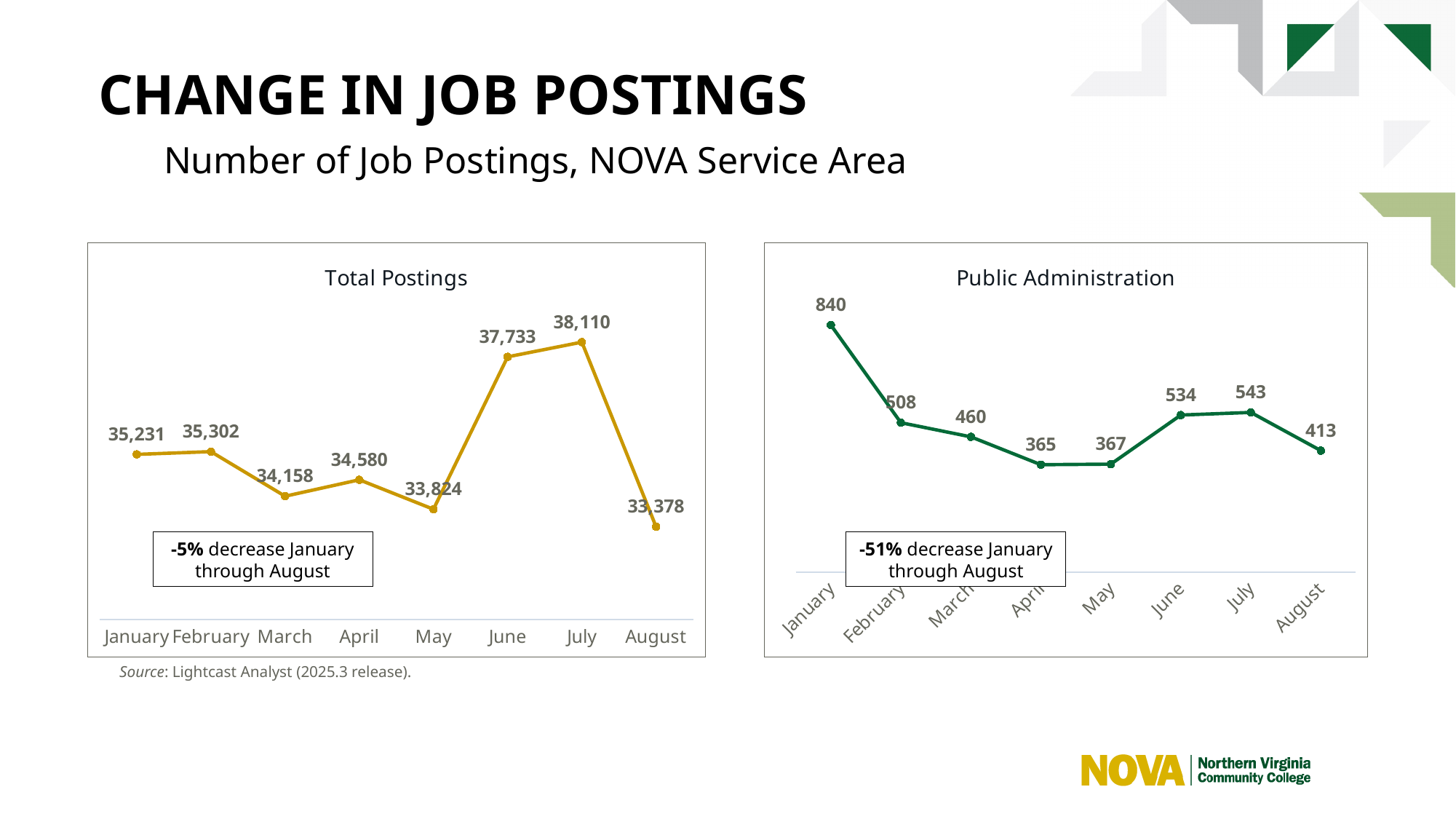
In the Public Administration chart, which month has the highest value? January In the Public Administration chart, what percentage decrease from January through August is noted in the text box? -51% In the Public Administration chart, what is the difference between the January and August values? 427 In the Total Postings chart, how many months are plotted? 8 In the Total Postings chart, what is the difference between the June and May values? 3,909 In the Total Postings chart, what is the value for July? 38,110 In the Public Administration chart, is the value for June or August larger? June In the Public Administration chart, which month has the lowest value? April In the Total Postings chart, do the values rise or fall from July to August? fall In the Public Administration chart, what is the value for January? 840 In the Total Postings chart, which month has the lowest value? August What kind of chart is the Total Postings chart? line chart